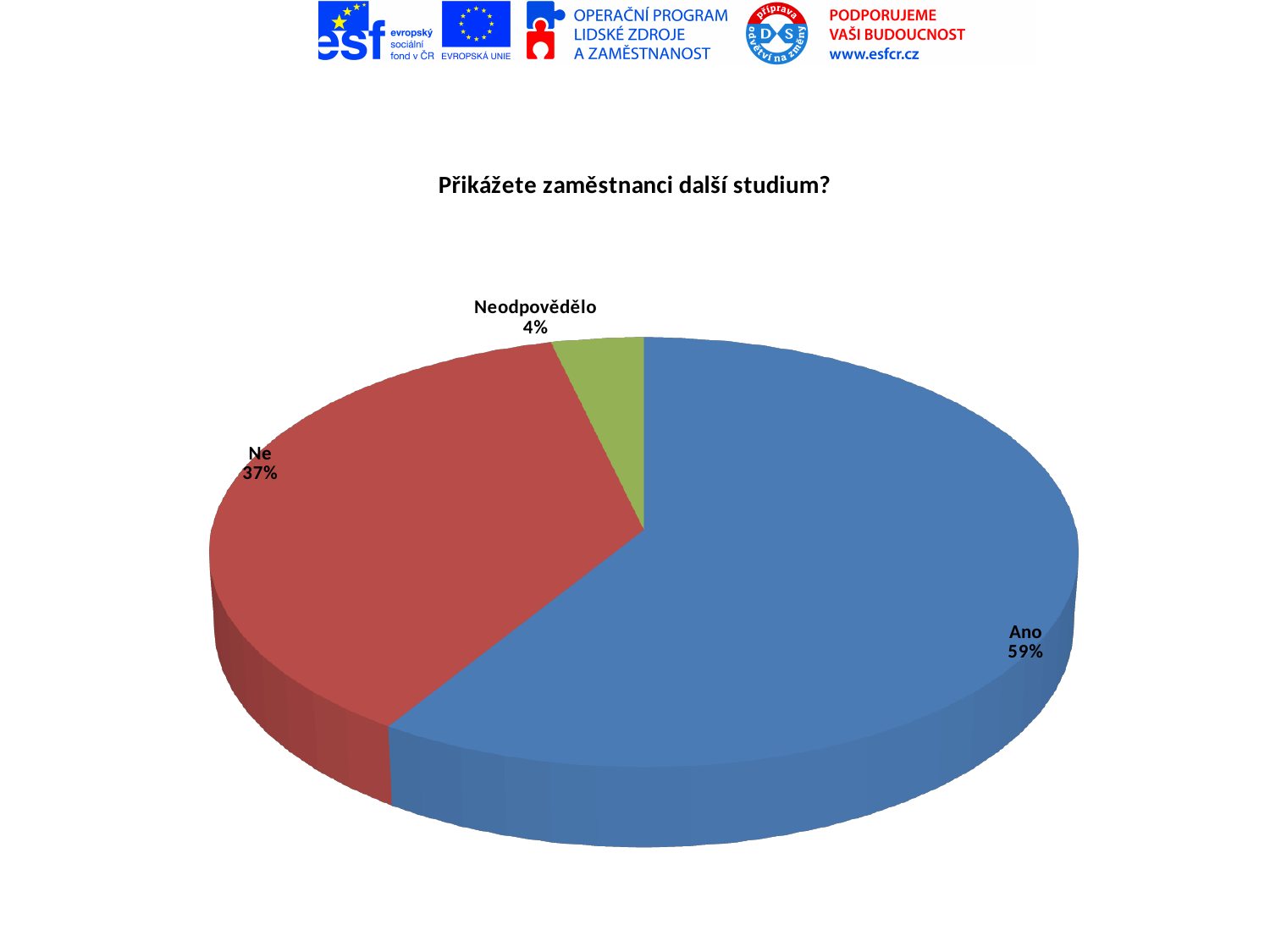
What is the difference in percentage points between the "Ano" and "Ne" slices? 22 Which category has the smallest slice of the pie? Neodpovědělo What kind of chart is shown on the slide? pie chart What share of the pie does the "Ano" slice represent? 59% Which category has the largest slice of the pie? Ano What colour is the "Ano" slice? blue How many slices does the pie chart have? 3 What share of the pie does the "Neodpovědělo" slice represent? 4% What share of the pie does the "Ne" slice represent? 37% What is the title of the chart? Přikážete zaměstnanci další studium? Which is larger, the "Ne" slice or the "Neodpovědělo" slice? Ne What is the difference in percentage points between the "Ne" and "Neodpovědělo" slices? 33